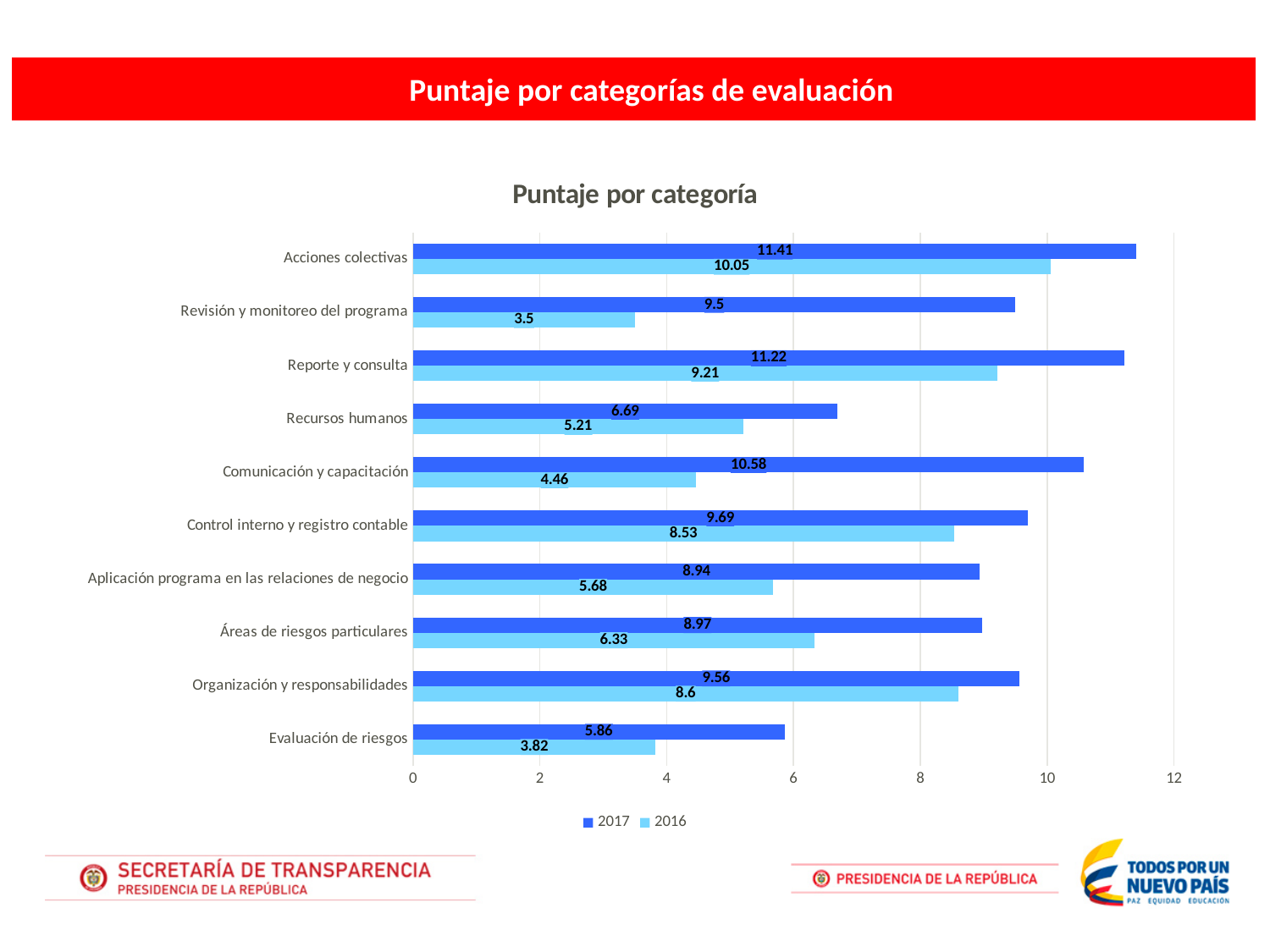
What is the 2017 value for Evaluación de riesgos? 5.86 Which category has the highest 2017 value? Acciones colectivas Which is larger: the 2016 value for Reporte y consulta or the 2016 value for Control interno y registro contable? Reporte y consulta How many series does the legend list? 2 How many categories are shown on the chart? 10 What is the difference between the 2017 and 2016 values for Revisión y monitoreo del programa? 6 What is the 2016 value for Revisión y monitoreo del programa? 3.5 Which category has the lowest 2017 value? Evaluación de riesgos What is the 2017 value for Acciones colectivas? 11.41 Which category has the lowest 2016 value? Revisión y monitoreo del programa What is the 2016 value for Comunicación y capacitación? 4.46 What is the difference between the 2017 and 2016 values for Comunicación y capacitación? 6.12